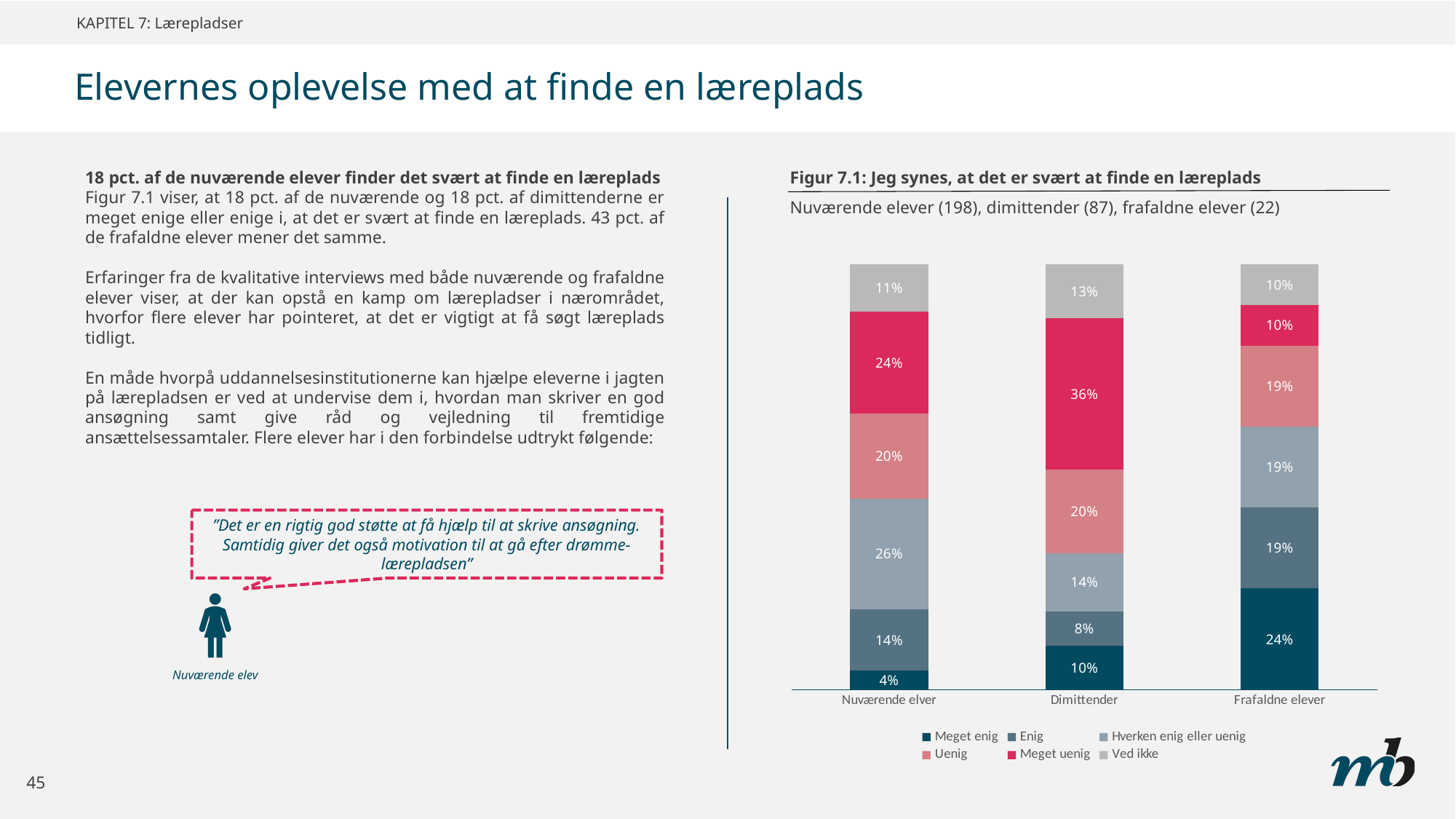
How many categories are shown on the x axis of Figur 7.1? 3 In Figur 7.1, what is the difference between the 'Meget uenig' values for Dimittender and Nuværende elver? 12 percentage points How many series does the legend of Figur 7.1 list? 6 Which category has the lowest 'Meget uenig' value in Figur 7.1? Frafaldne elever What is the 'Meget uenig' value for Dimittender in Figur 7.1? 36% In Figur 7.1, is the 'Enig' value larger for Nuværende elver or for Dimittender? Nuværende elver What is the title of the chart on the slide? Figur 7.1: Jeg synes, at det er svært at finde en læreplads Which category has the highest 'Meget enig' value in Figur 7.1? Frafaldne elever What is the 'Ved ikke' value for Dimittender in Figur 7.1? 13% What kind of chart is Figur 7.1? Stacked bar chart What is the 'Meget enig' value for Frafaldne elever in Figur 7.1? 24% What is the 'Hverken enig eller uenig' value for Nuværende elver in Figur 7.1? 26%